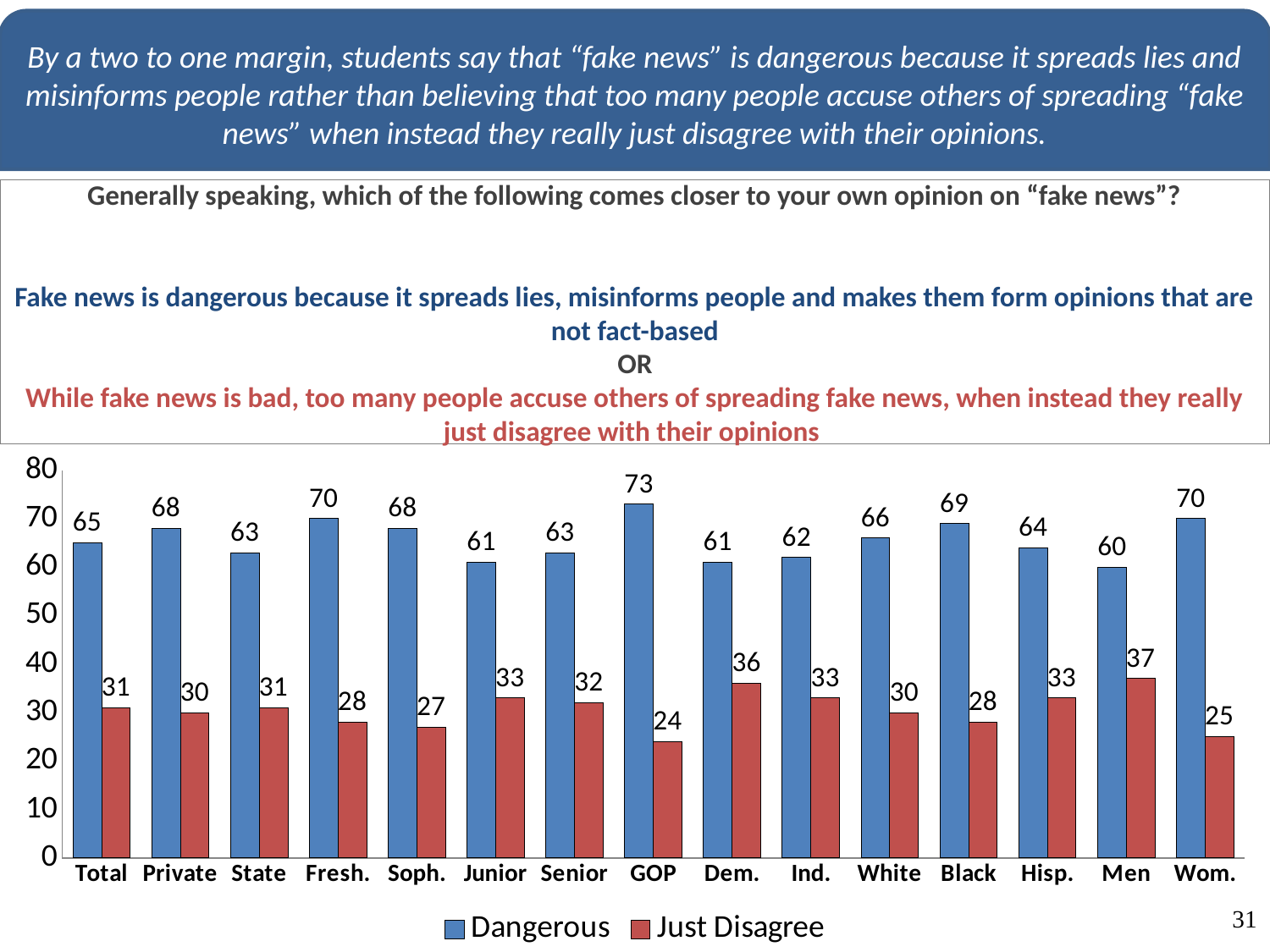
What is the difference between the Dangerous and Just Disagree values for Wom.? 45 Which is larger, the Just Disagree value for Men or for Dem.? Men What is the value for Just Disagree for GOP? 24 What is the total of the Dangerous and Just Disagree values for Black? 97 Which category has the lowest Just Disagree value? GOP What is the value for Dangerous for the Total category? 65 What colour are the Just Disagree bars? Red How many series does the legend list? 2 Which category has the highest Dangerous value? GOP What is the value for Dangerous for Men? 60 What kind of chart is shown on the slide? Bar chart How many categories are shown on the x axis? 15